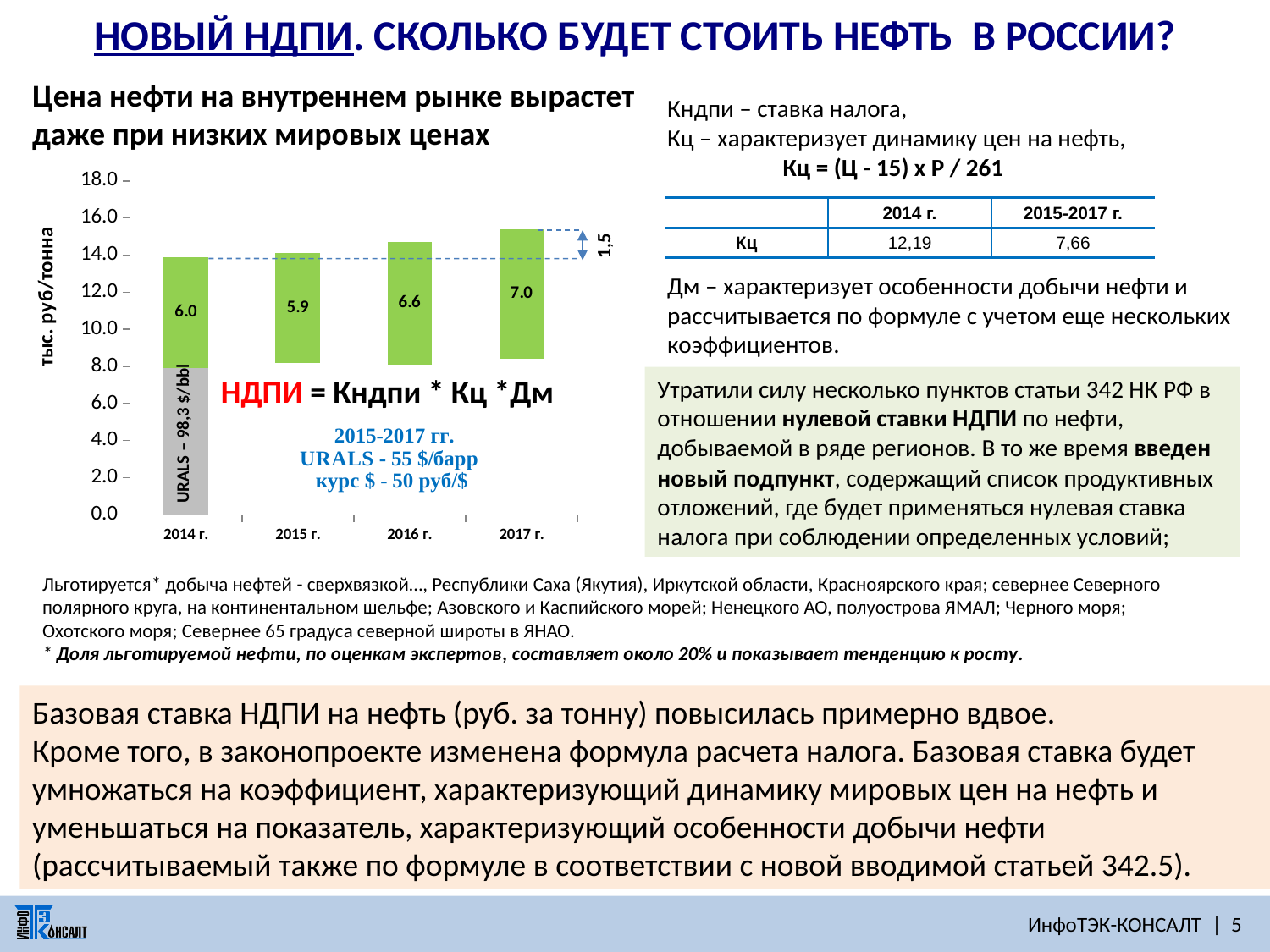
What is the value of the green segment for 2016 г.? 6.6 What is the value of the green segment for 2017 г.? 7.0 Which year has the lowest labelled green segment value? 2015 г. Which green segment value is larger, 2016 г. or 2015 г.? 2016 г. What kind of chart is shown on the slide? bar chart Is the top of the bar for 2017 г. greater or less than 14.0? greater What is the label of the vertical axis of the chart? тыс. руб/тонна What is the value of the green segment for 2014 г.? 6.0 What is the difference between the green segment values for 2017 г. and 2014 г.? 1.0 What is the difference between the green segment values for 2016 г. and 2015 г.? 0.7 How many years are shown on the x axis of the chart? 4 Which year has the highest labelled green segment value? 2017 г.